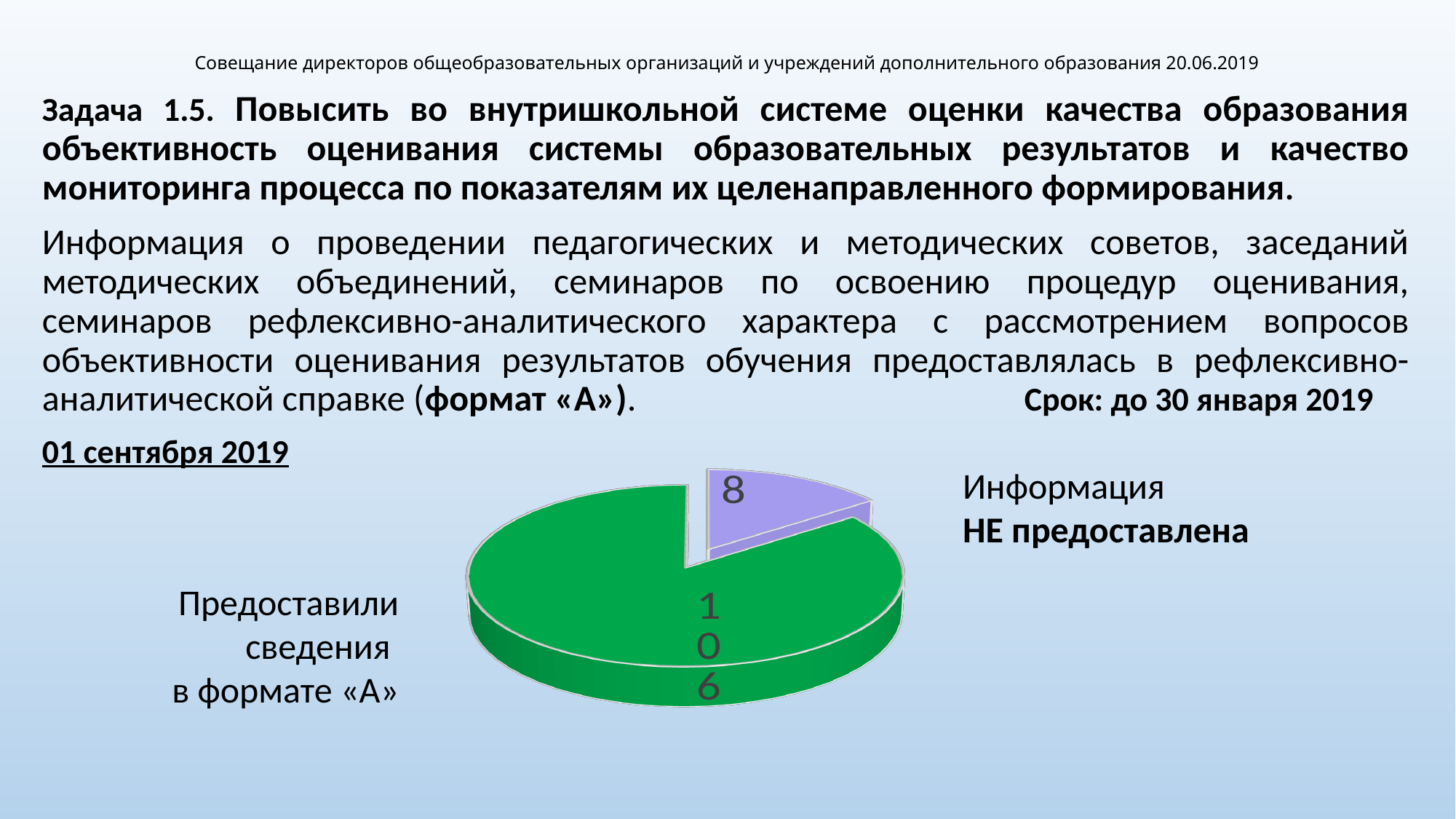
Which slice of the pie chart is the largest? Предоставили сведения в формате «А» What value is shown for the slice 'Предоставили сведения в формате «А»'? 106 What value is shown for the slice 'Информация НЕ предоставлена'? 8 Which slice of the pie chart is the smallest? Информация НЕ предоставлена What colour is the slice labelled 8? purple What date is given above the pie chart? 01 сентября 2019 How many slices does the pie chart have? 2 What colour is the slice labelled 106? green What type of chart is shown on the slide? pie chart What is the difference between the number that provided information in format «А» and the number that did not provide information? 98 Which is larger: the slice for 'Предоставили сведения в формате «А»' or the slice for 'Информация НЕ предоставлена'? Предоставили сведения в формате «А» What is the total of the two values shown in the pie chart? 114